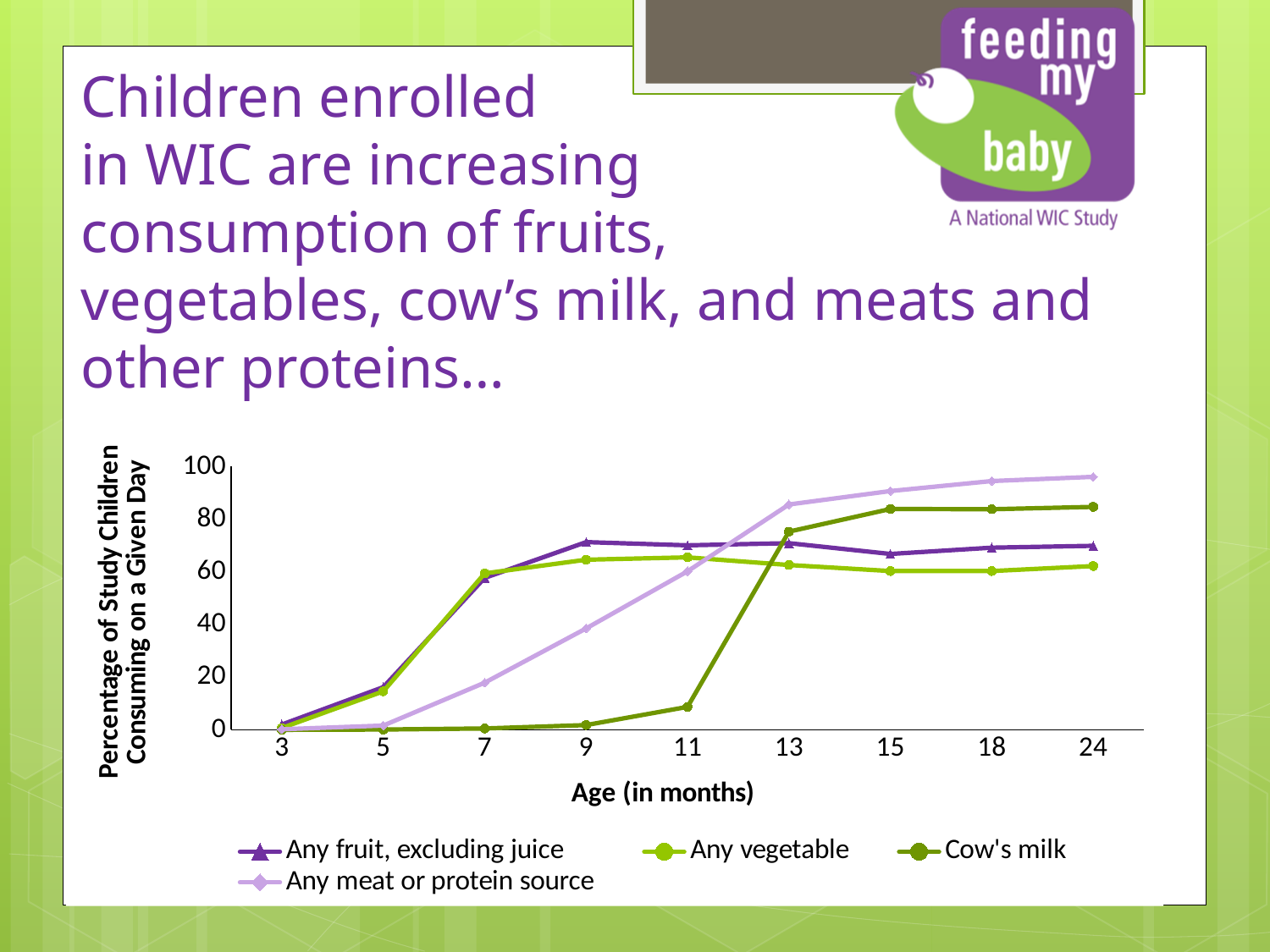
What is the x-axis title of the chart? Age (in months) Which series has the lowest value at 24 months? Any vegetable Is the value for Any fruit, excluding juice at 9 months greater or less than 60? greater What kind of chart is shown on the slide? line chart At 15 months, which is larger: Cow's milk or Any fruit, excluding juice? Cow's milk How many age points are plotted along the x axis? 9 Is the value for Any meat or protein source at 13 months greater or less than 80? greater Does the Any meat or protein source series rise or fall from 3 months to 24 months? rise Is the value for Cow's milk at 11 months greater or less than 20? less How many series does the legend list? 4 At 7 months, which is larger: Any vegetable or Any meat or protein source? Any vegetable Which series has the highest value at 24 months? Any meat or protein source